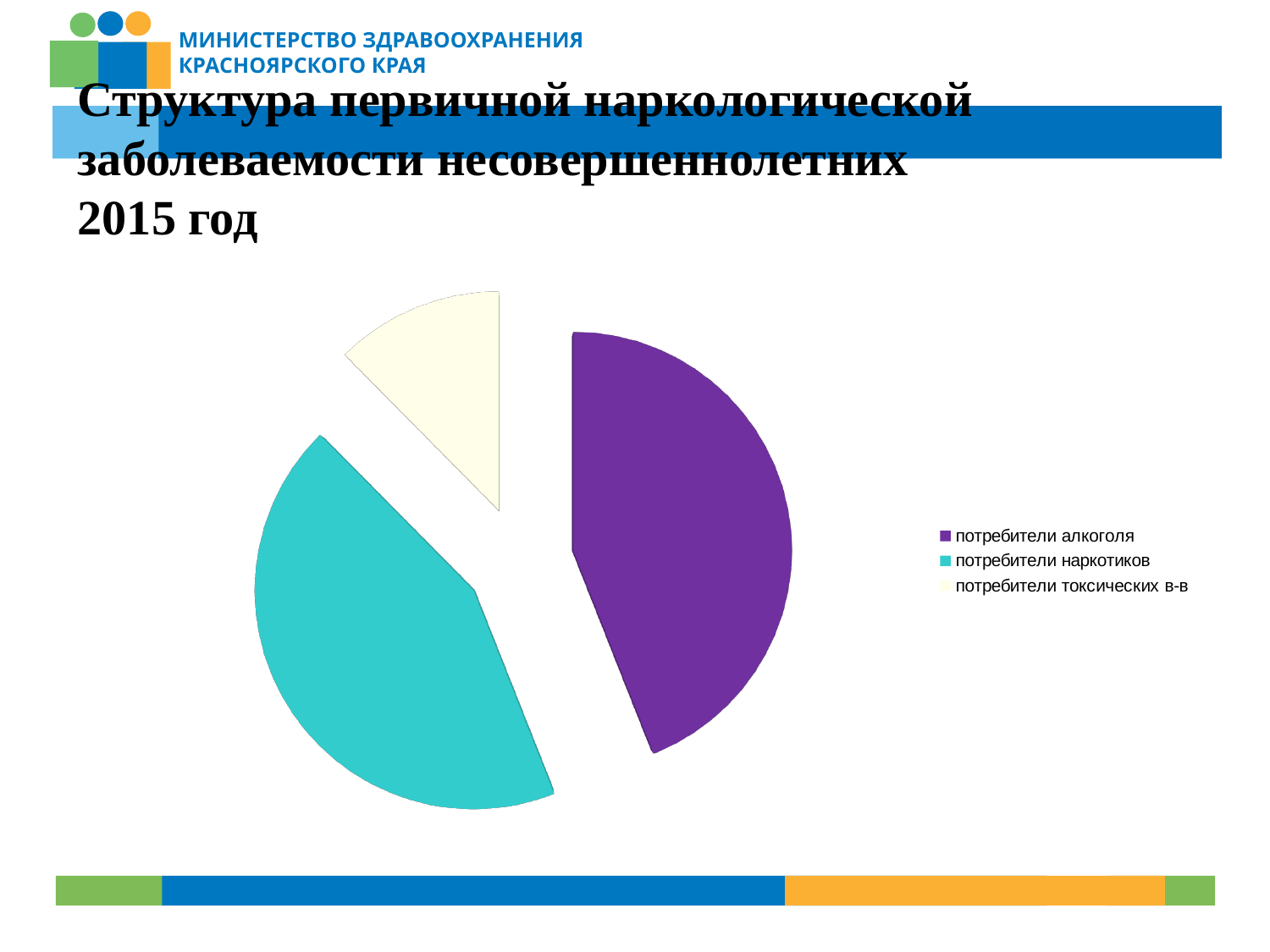
How many entries does the legend of the pie chart list? 3 How many slices does the pie chart have? 3 Which slice is larger: потребители наркотиков or потребители токсических в-в? потребители наркотиков Which slice is smaller: потребители алкоголя or потребители токсических в-в? потребители токсических в-в Which category has the smallest slice of the pie chart? потребители токсических в-в Which year does the chart title refer to? 2015 What colour is the slice for потребители наркотиков? teal What kind of chart is shown on the slide? pie chart